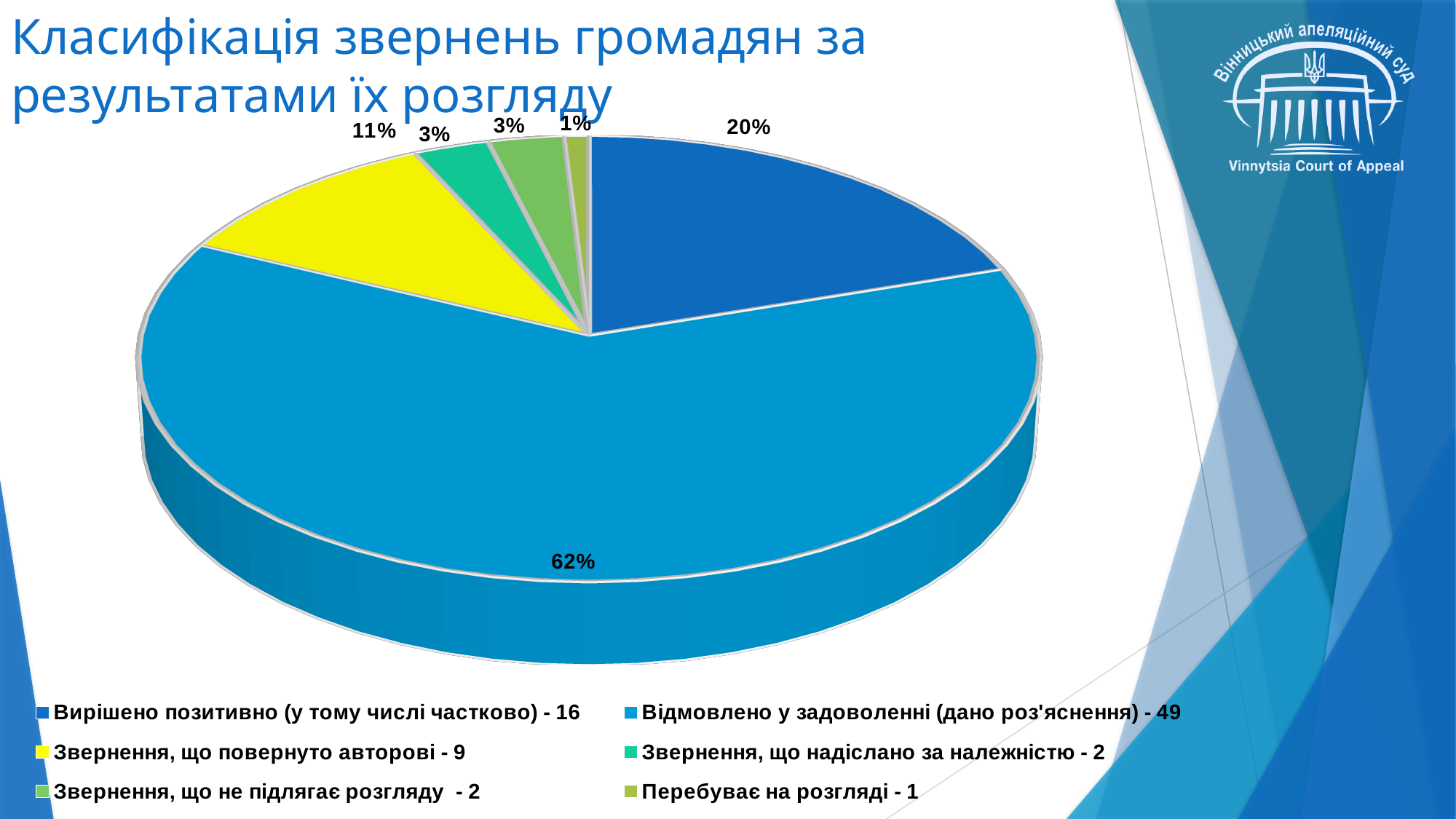
What percentage share does the slice "Вирішено позитивно (у тому числі частково)" have? 20% How many categories does the legend list? 6 Which slice is larger: "Вирішено позитивно (у тому числі частково)" or "Звернення, що повернуто авторові"? Вирішено позитивно (у тому числі частково) What percentage share does the slice "Звернення, що повернуто авторові" have? 11% What percentage share does the slice "Відмовлено у задоволенні (дано роз'яснення)" have? 62% How many appeals are listed in the legend for "Відмовлено у задоволенні (дано роз'яснення)"? 49 How many appeals are listed in the legend for "Звернення, що повернуто авторові"? 9 Which category has the largest slice of the pie? Відмовлено у задоволенні (дано роз'яснення) What is the difference in percentage points between the 62% slice and the 20% slice? 42 What kind of chart is shown on the slide? pie chart Which category has the smallest slice of the pie? Перебуває на розгляді